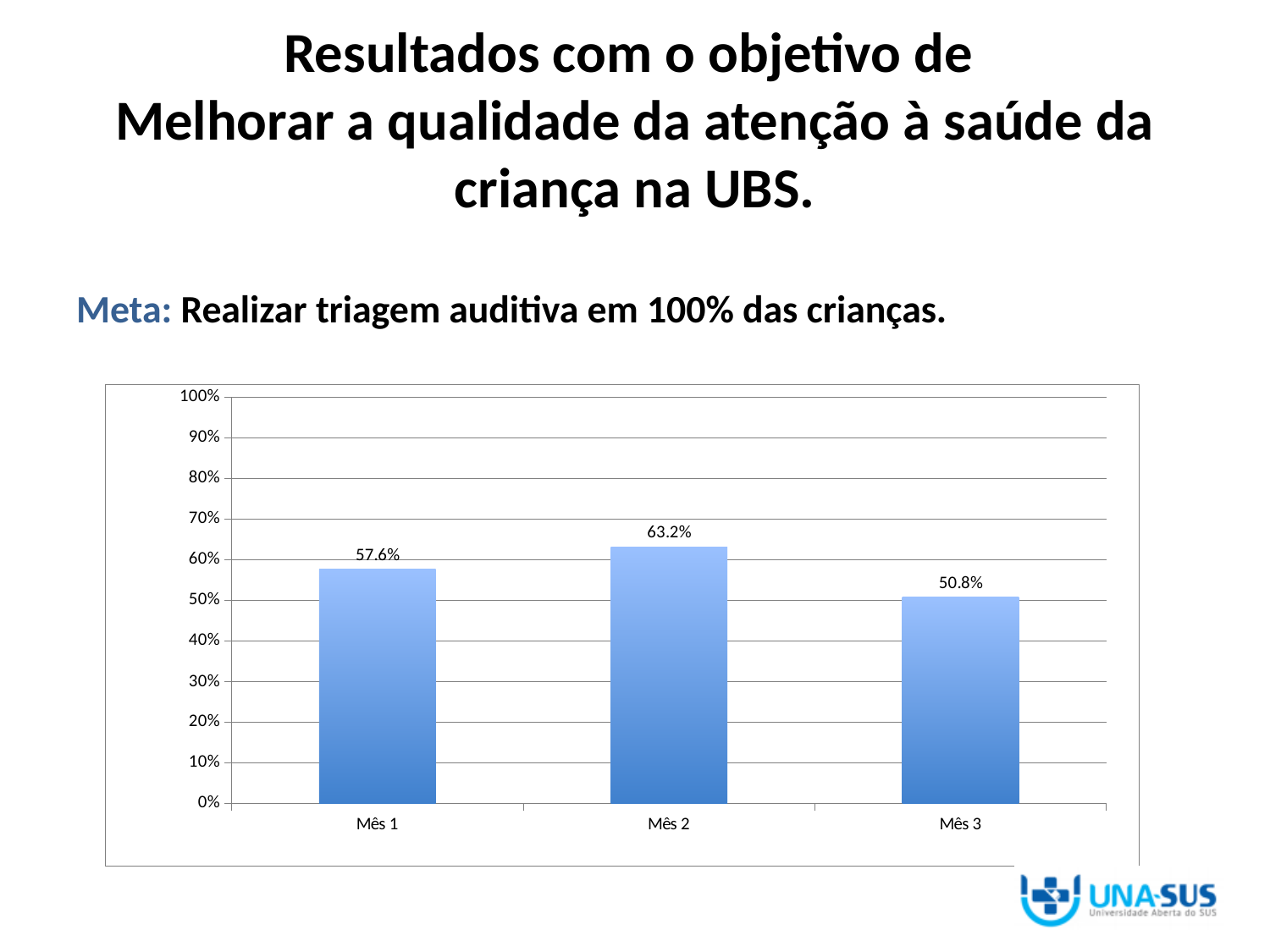
Is the value for Mês 2 greater or less than 60%? greater What kind of chart is shown on the slide? bar chart Which month has the lowest value? Mês 3 What is the maximum value shown on the y axis? 100% What is the difference between the values for Mês 2 and Mês 3? 12.4% What is the value for Mês 1? 57.6% Which month has the highest value? Mês 2 What is the value for Mês 2? 63.2% What is the difference between the values for Mês 2 and Mês 1? 5.6% Which is larger, the value for Mês 1 or the value for Mês 3? Mês 1 What is the value for Mês 3? 50.8% How many months are shown on the x axis? 3